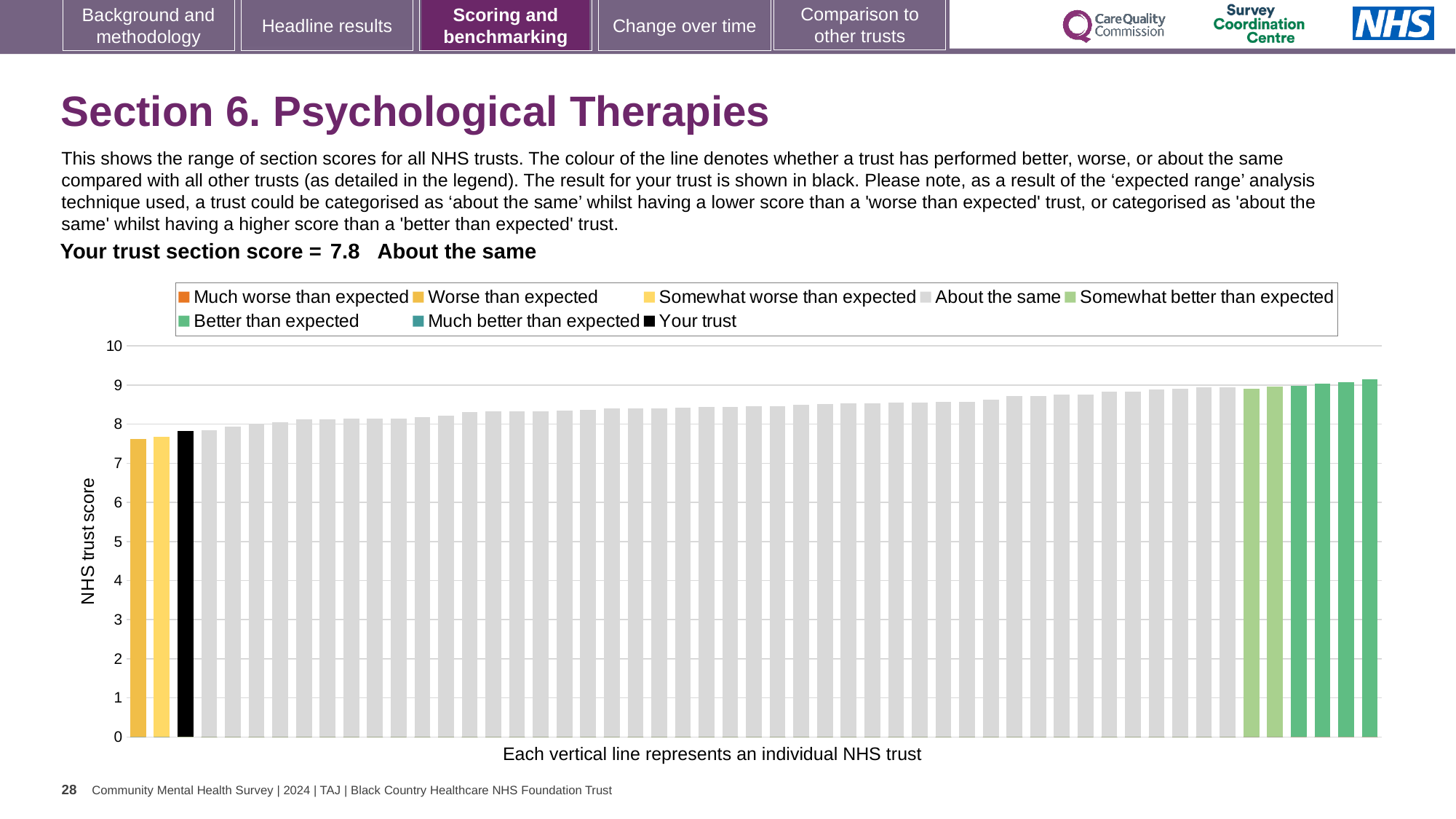
Is the value of the black 'Your trust' bar greater or less than 8? less How many entries does the chart legend list? 8 Do the bar values rise or fall from left to right across the chart? rise Which category is the trust's section score placed in according to the slide? About the same What kind of chart is shown on the slide? bar chart What is the trust's section score for Psychological Therapies shown on the slide? 7.8 How many bars are coloured as 'Worse than expected' (yellow) in the chart? 1 How many bars are coloured as 'Better than expected' (darker green) in the chart? 4 What is the label on the vertical axis of the chart? NHS trust score Is the value of the tallest bar in the chart greater or less than 9? greater What colour is the bar representing 'Your trust'? black Is the value of the shortest bar in the chart greater or less than 7? greater